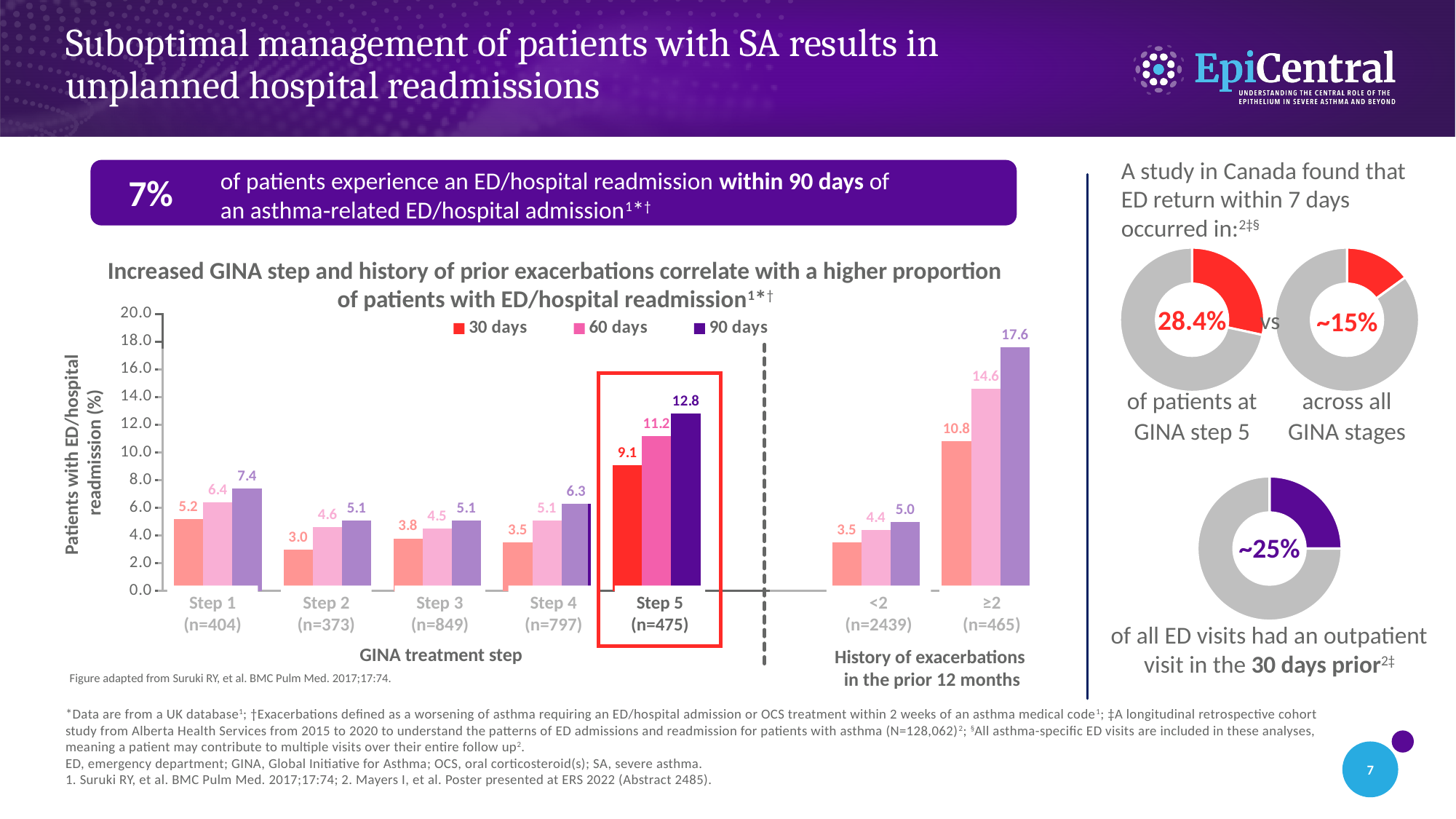
In the bar chart, what is the 30 days value for the ≥2 exacerbations group (n=465)? 10.8 In the bar chart, what is the difference between the 90 days values for ≥2 (n=465) and <2 (n=2439)? 12.6 How many series does the legend of the bar chart list? 3 What are the three legend entries of the bar chart? 30 days, 60 days, 90 days What type of chart is used to show patients with ED/hospital readmission by GINA treatment step? Bar chart In the bar chart, which GINA treatment step has the lowest 30 days value? Step 2 (n=373) In the donut chart labelled 'across all GINA stages', what percentage is shown? ~15% How many categories are shown on the x axis of the bar chart? 7 In the bar chart, what is the 90 days value for Step 5 (n=475)? 12.8 In the bar chart, which category has the highest 90 days value? ≥2 (n=465) In the bar chart, which has the larger 60 days value, Step 1 or Step 4? Step 1 In the left donut chart on the right side of the slide, what percentage of patients at GINA step 5 had an ED return within 7 days? 28.4%